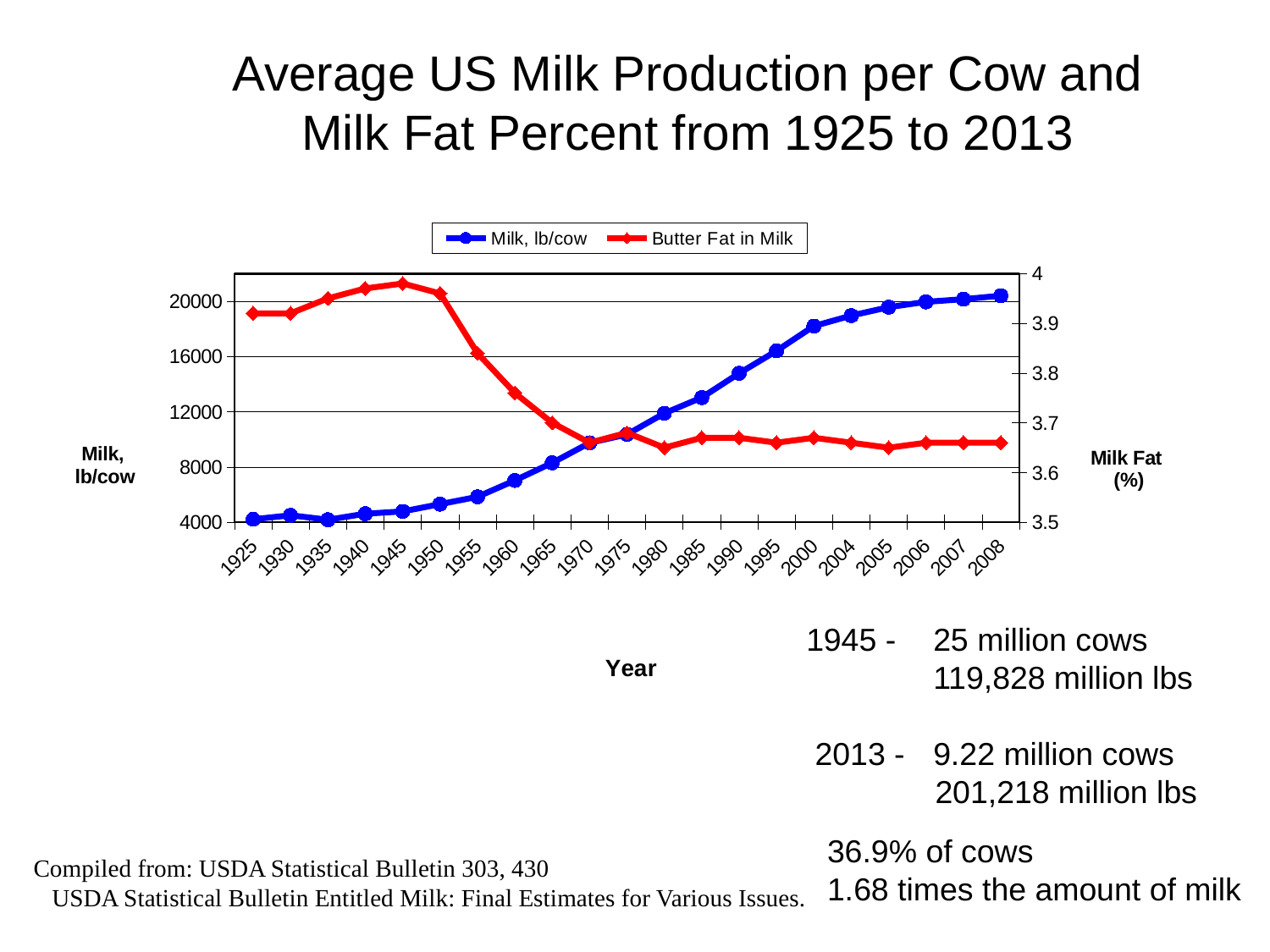
What kind of chart is shown on the slide? line chart Which is larger, Milk, lb/cow in 1990 or in 1970? 1990 How many years are plotted along the x axis? 21 Which colour is used for the Butter Fat in Milk series? red How many series does the legend list? 2 Is the value for Milk, lb/cow in 1925 greater or less than 8000? less Which year has the highest value for Butter Fat in Milk? 1945 Does the Milk, lb/cow series rise or fall from 1925 to 2008? rise Which year has the highest value for Milk, lb/cow? 2008 Is the value for Milk, lb/cow in 1985 greater or less than 12000? greater Is the value for Butter Fat in Milk in 1960 greater or less than 3.7? greater